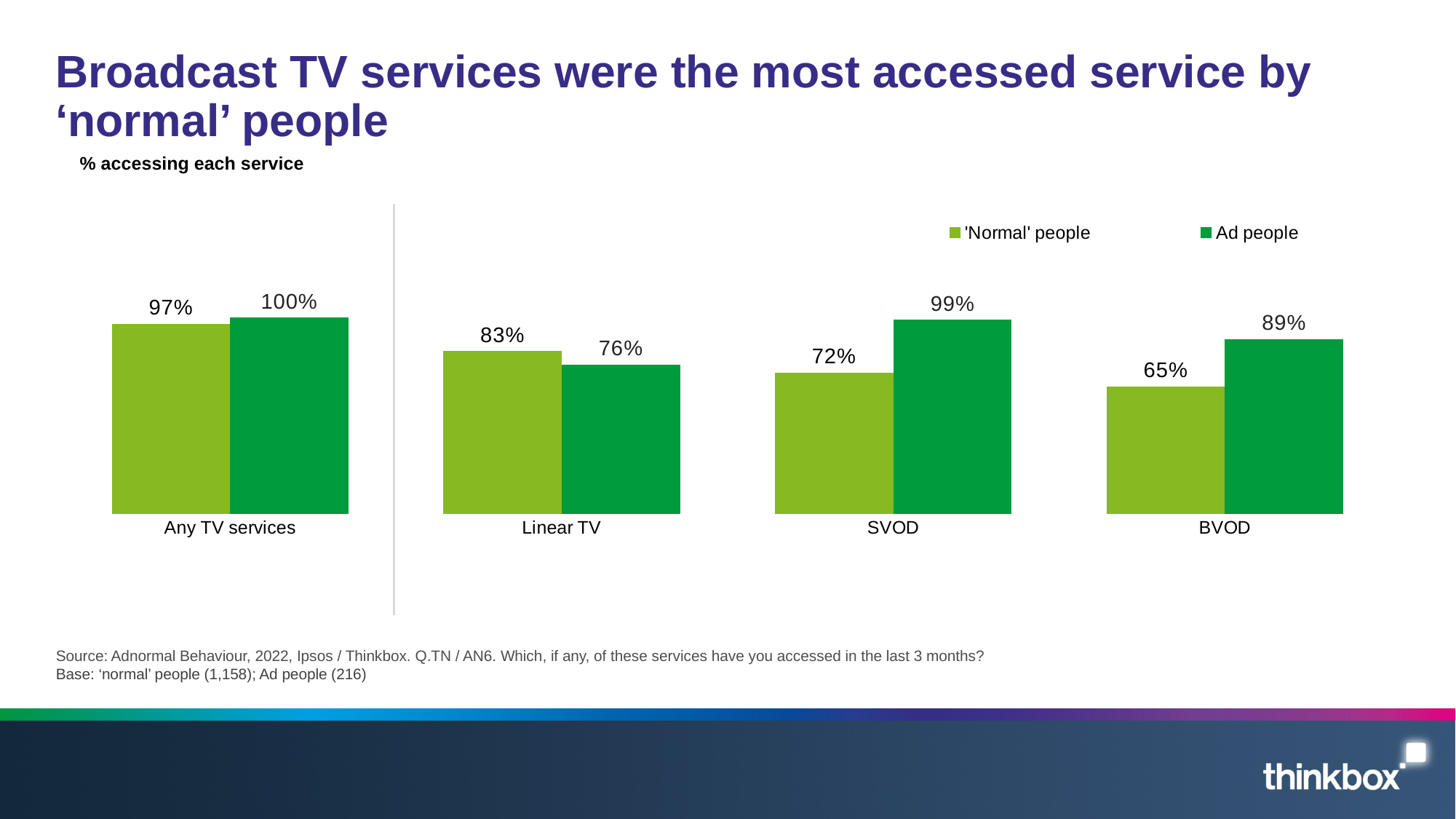
How many series does the legend list? 2 What percentage of 'Normal' people accessed BVOD? 65% What percentage of Ad people accessed Any TV services? 100% How many service categories are shown on the chart? 4 What kind of chart is shown on the slide? Bar chart Which service has the lowest value for Ad people? Linear TV For BVOD, which group has the higher value, 'Normal' people or Ad people? Ad people Which service has the lowest value for 'Normal' people? BVOD What percentage of Ad people accessed SVOD? 99% What percentage of 'Normal' people accessed Linear TV? 83% What is the difference between Ad people and 'Normal' people for SVOD? 27% What is the difference between 'Normal' people and Ad people for Linear TV? 7%